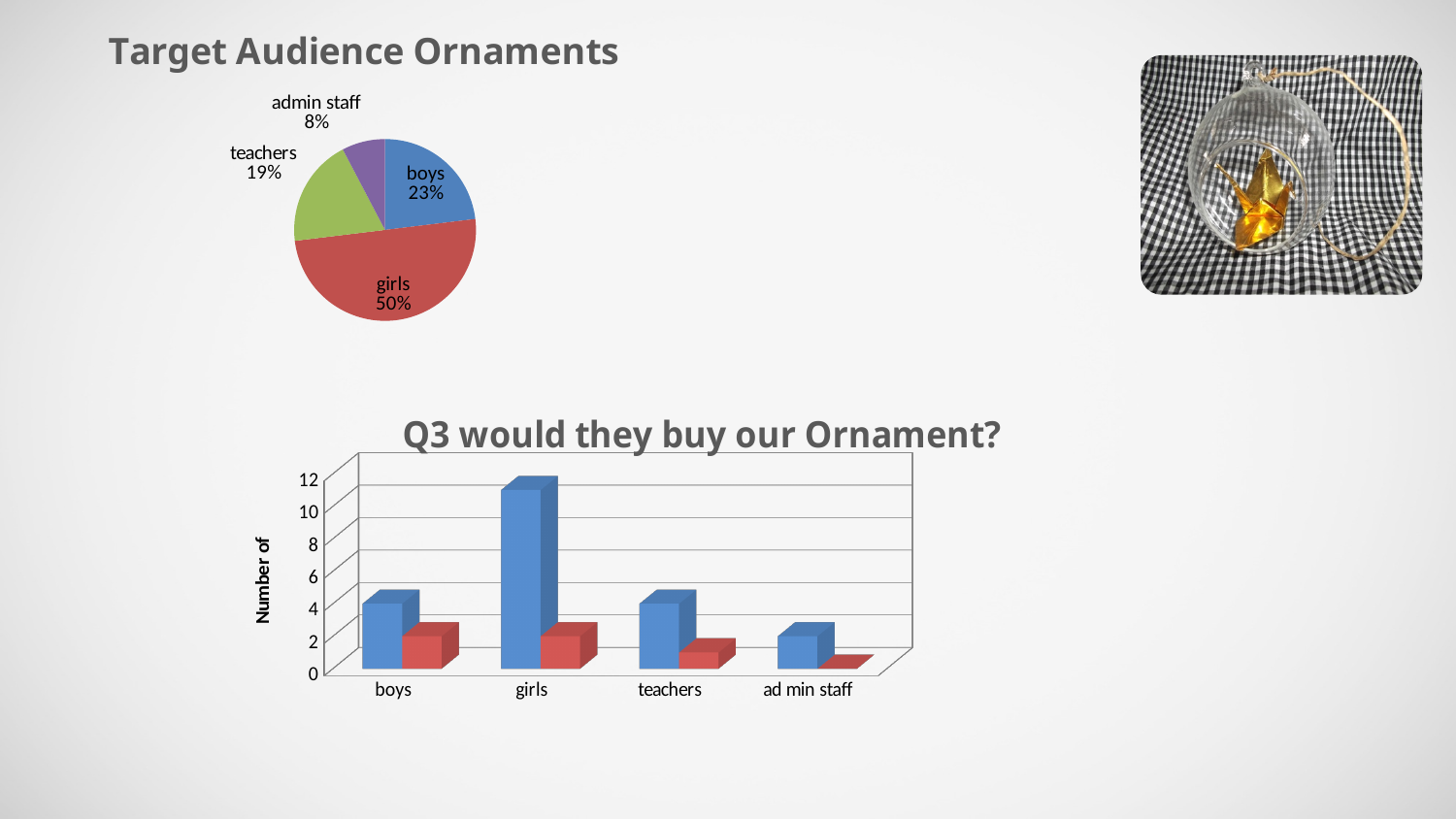
In the pie chart at the top left, which category has the largest slice? girls In the pie chart at the top left, how many percentage points larger is the girls slice than the boys slice? 27 In the chart titled 'Q3 would they buy our Ornament?', what is the label on the vertical axis? Number of In the pie chart at the top left, how many slices does the pie have? 4 In the chart titled 'Q3 would they buy our Ornament?', how many categories are shown on the x axis? 4 In the pie chart at the top left, what share of the pie is girls? 50% What kind of chart is the chart titled 'Q3 would they buy our Ornament?'? bar chart In the pie chart at the top left, which category has the smallest slice? admin staff In the pie chart at the top left, what percentage is shown for teachers? 19% In the chart titled 'Q3 would they buy our Ornament?', is the blue bar for ad min staff greater or less than 4? less In the chart titled 'Q3 would they buy our Ornament?', is the blue bar for girls greater or less than 8? greater In the chart titled 'Q3 would they buy our Ornament?', which category has the tallest blue bar? girls